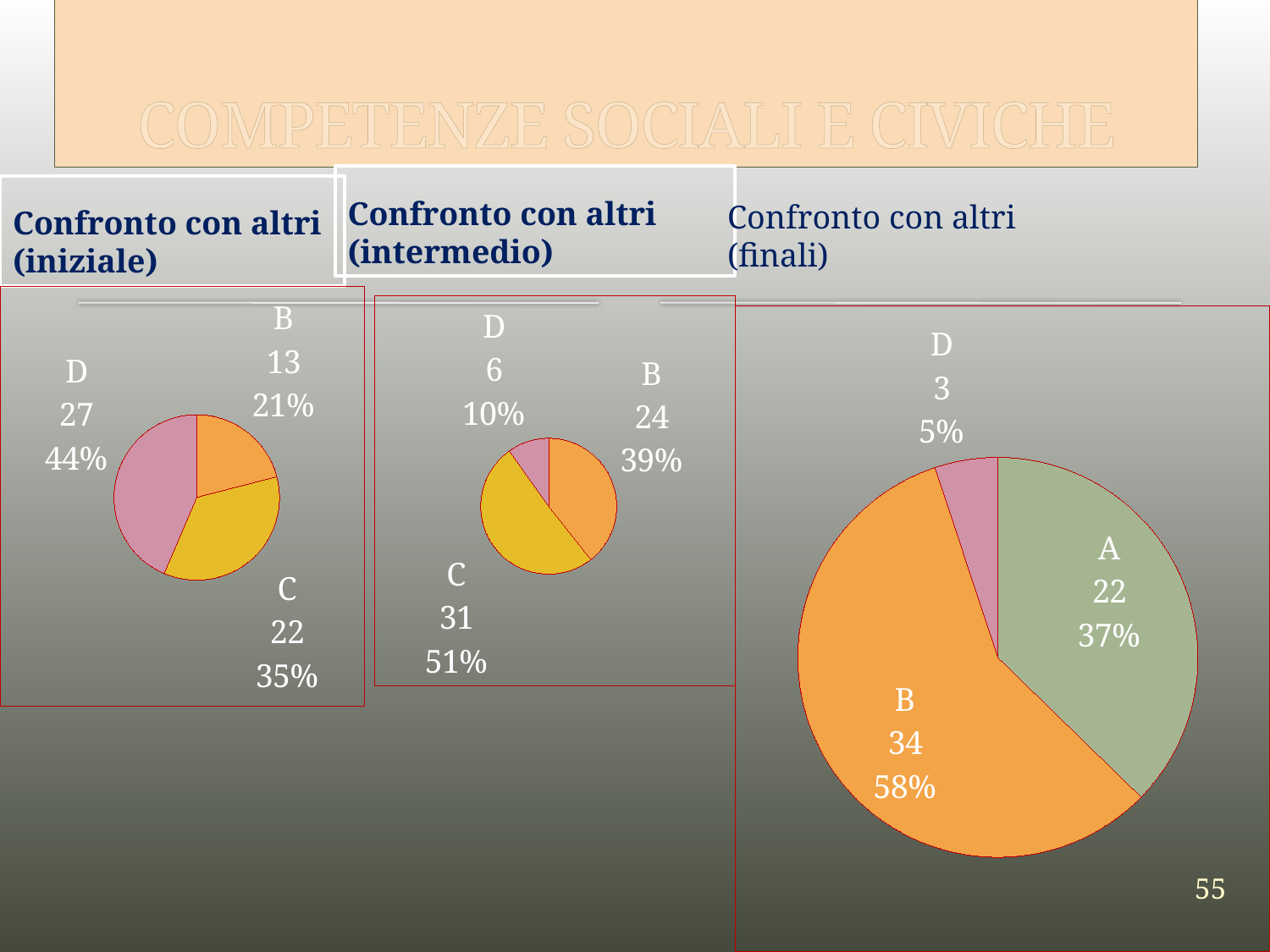
In the 'Confronto con altri (iniziale)' chart, what percentage share does category C have? 35% In the 'Confronto con altri (intermedio)' chart, which category has the smallest slice? D How many slices does the 'Confronto con altri (finali)' pie chart have? 3 In the 'Confronto con altri (intermedio)' chart, what value is shown for category C? 31 In the 'Confronto con altri (iniziale)' chart, what value is shown for category D? 27 In the 'Confronto con altri (finali)' chart, which is larger, the value for A or the value for B? B What type of chart is used for 'Confronto con altri (intermedio)'? Pie chart In the 'Confronto con altri (finali)' chart, what value is shown for category B? 34 In the 'Confronto con altri (iniziale)' chart, what is the difference between the values for D and B? 14 In the 'Confronto con altri (finali)' chart, what percentage share does category A have? 37% In the 'Confronto con altri (intermedio)' chart, what percentage share does category B have? 39% In the 'Confronto con altri (iniziale)' chart, which category has the largest slice? D